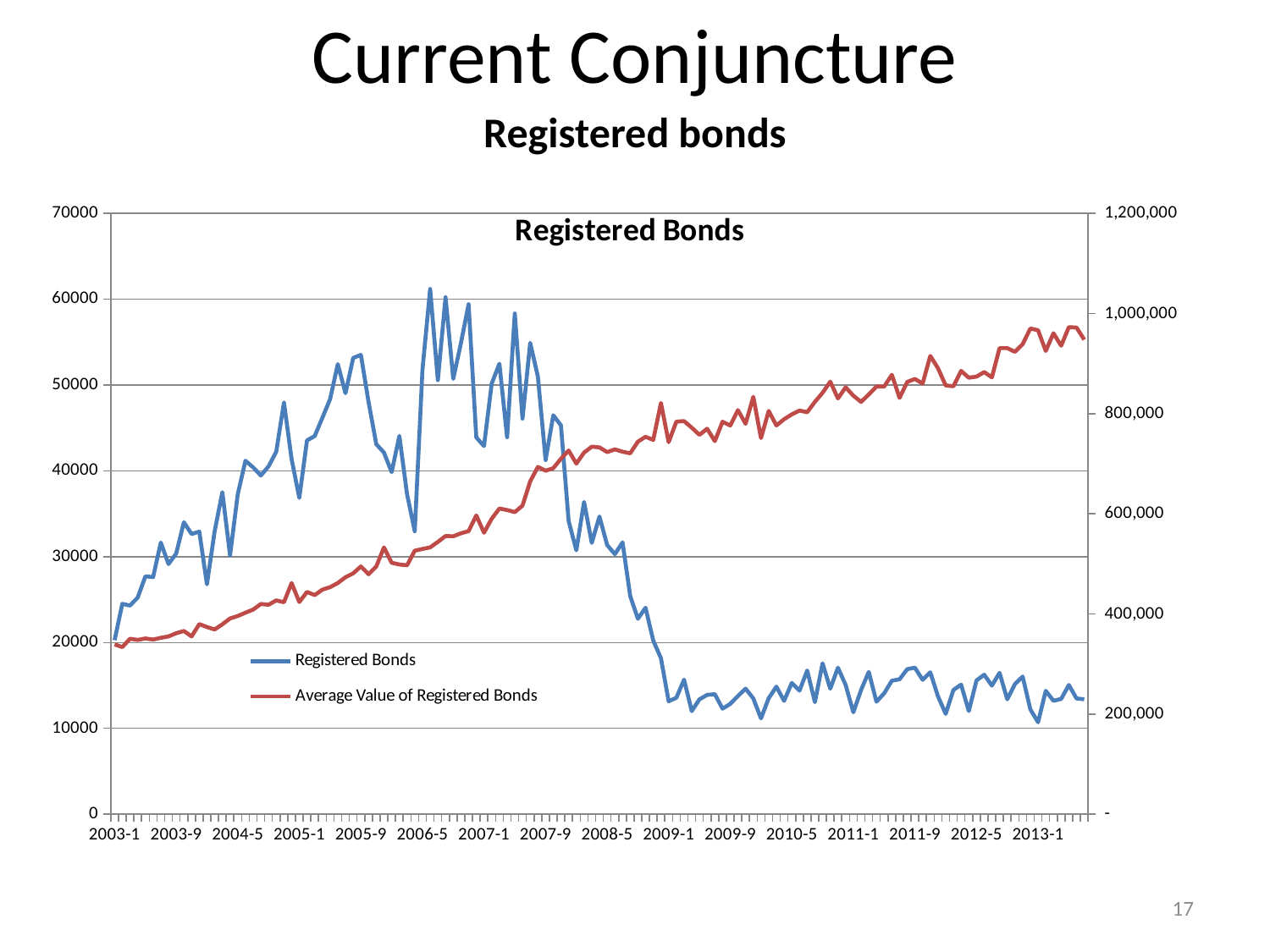
Does the Average Value of Registered Bonds series generally rise or fall from 2003-1 to 2013-1? rise Which series is drawn in red? Average Value of Registered Bonds Is the value for Registered Bonds at 2009-1 greater or less than 20000? less What kind of chart is shown on the slide? line chart What is the title of the chart? Registered Bonds Is the value for Average Value of Registered Bonds at 2013-1 greater or less than 800,000? greater Is the value for Average Value of Registered Bonds at 2003-1 greater or less than 400,000? less Does the Registered Bonds series rise or fall between 2008-5 and 2009-1? fall How many series does the legend list? 2